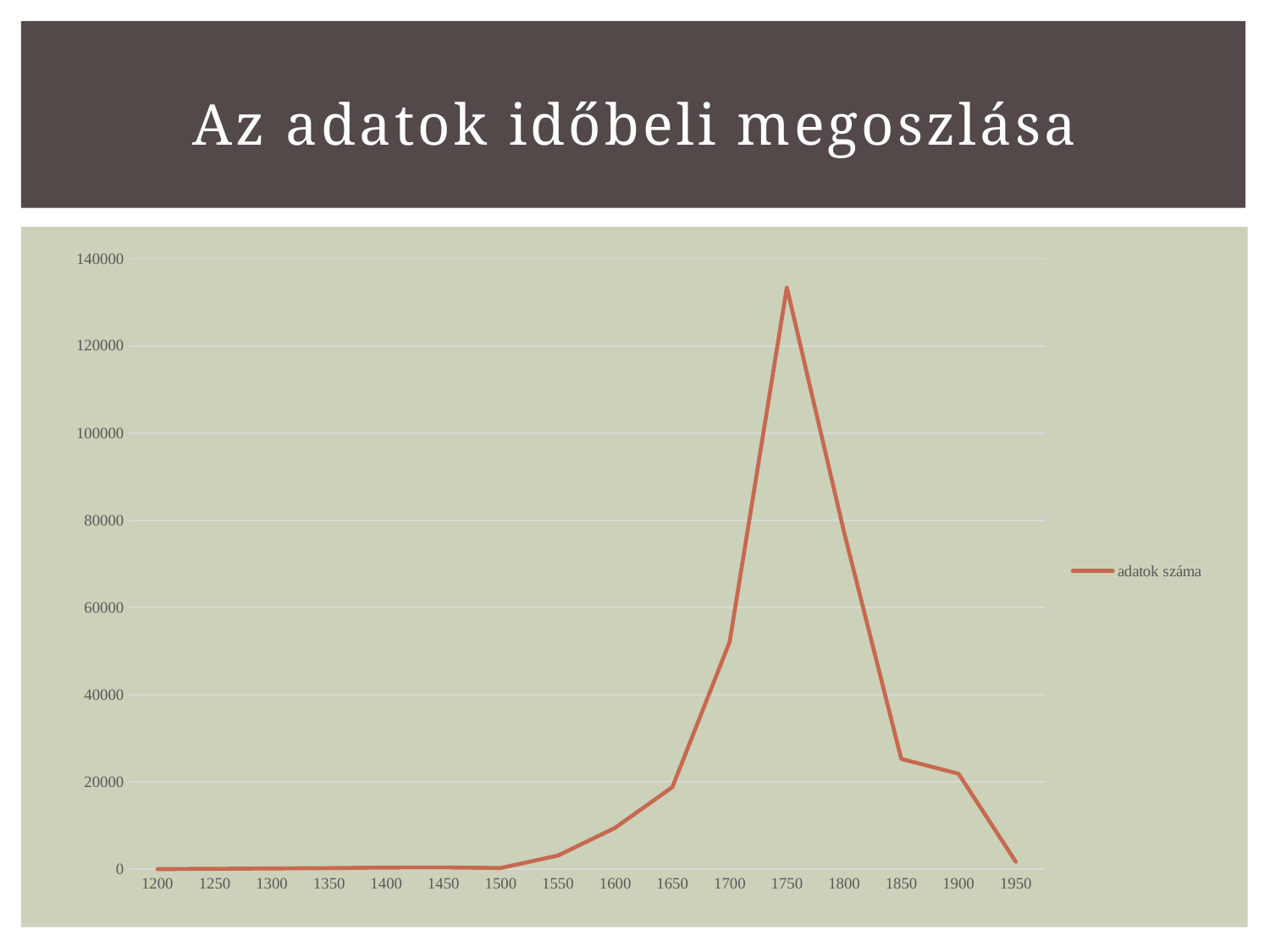
What is the name of the series shown in the legend? adatok száma What is the title of the slide containing the chart? Az adatok időbeli megoszlása Is the value for 1950 greater or less than 20000? less Which has the larger value, 1750 or 1800? 1750 Is the value for 1750 greater or less than 120000? greater What kind of chart is shown on the slide? line chart Is the value for 1700 greater or less than 40000? greater How many points are plotted along the x axis? 16 How many series does the legend list? 1 Do the values rise or fall along the x axis from 1750 to 1950? fall At which year does the line reach its highest value? 1750